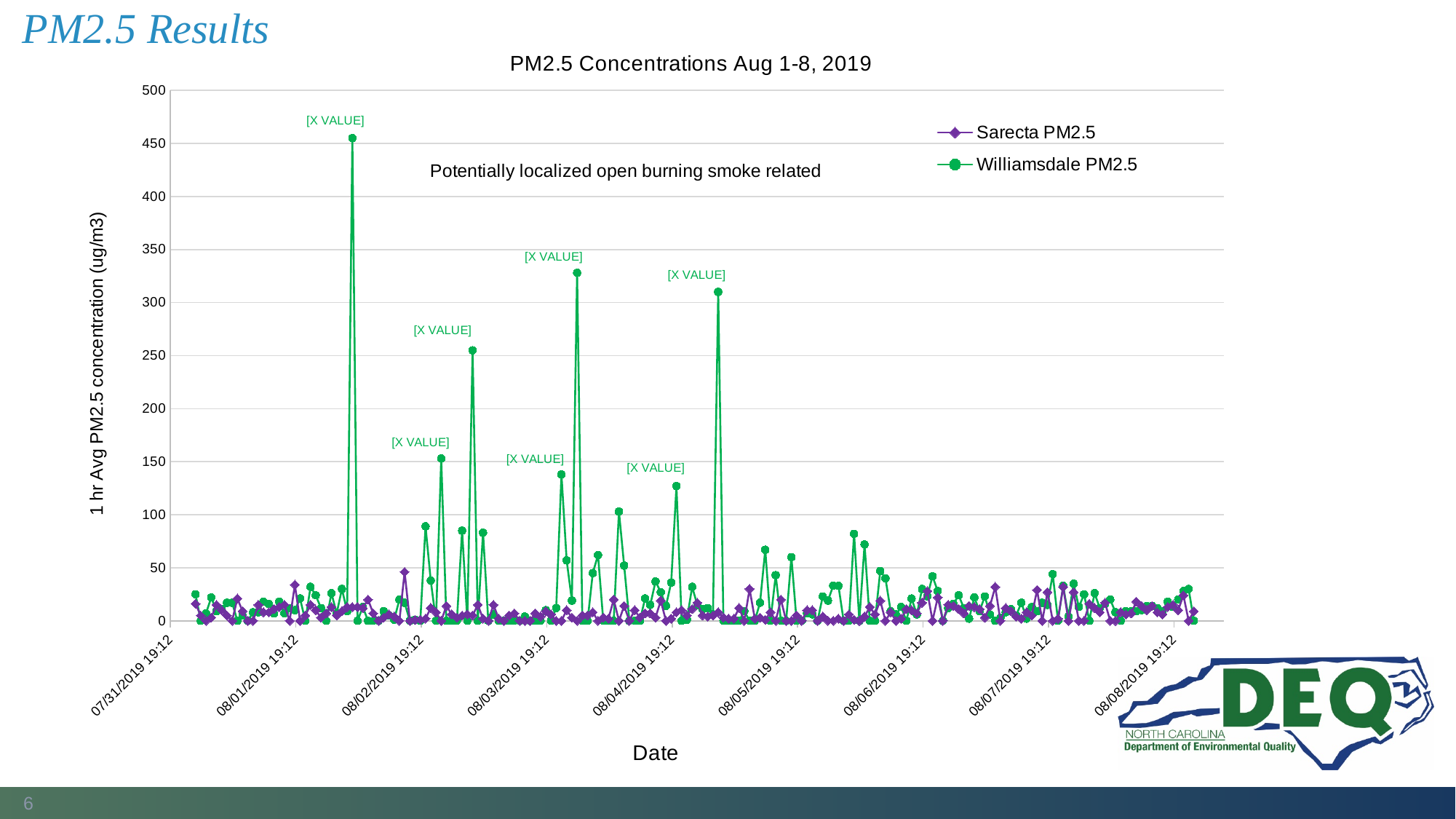
Is the highest value of the Sarecta PM2.5 series greater or less than 100? less What annotation text is written inside the plot area near the top of the chart? Potentially localized open burning smoke related Which series reaches the highest value on the chart? Williamsdale PM2.5 What kind of chart is shown on the slide? line chart How many series does the legend list? 2 How many '[X VALUE]' data labels are shown on the Williamsdale PM2.5 series? 7 What is the title of the chart? PM2.5 Concentrations Aug 1-8, 2019 Which series has the larger peak values overall, Sarecta PM2.5 or Williamsdale PM2.5? Williamsdale PM2.5 Is the highest peak of the Williamsdale PM2.5 series greater or less than 400? greater How many date labels are shown along the x axis? 9 Is the highest Williamsdale PM2.5 peak between 08/02/2019 19:12 and 08/03/2019 19:12 greater or less than 200? greater